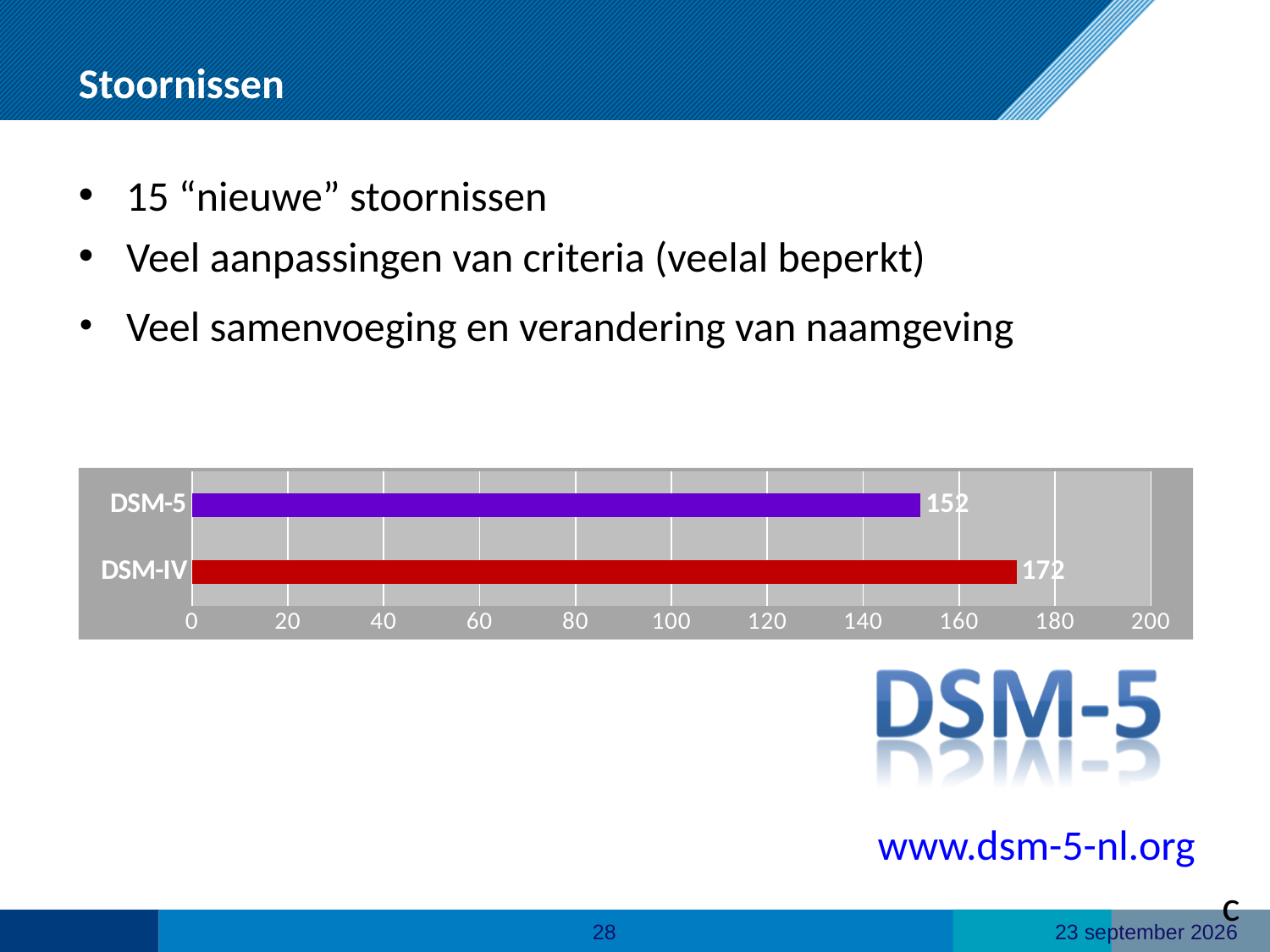
What kind of chart is shown on the slide? bar chart Is the value for DSM-5 greater or less than 140? greater What is the difference between the values for DSM-IV and DSM-5? 20 What is the value for DSM-IV? 172 Which is larger, the value for DSM-5 or the value for DSM-IV? DSM-IV Which category has the lowest value? DSM-5 What is the value for DSM-5? 152 What is the maximum value shown on the horizontal axis? 200 What colour is the bar for DSM-IV? red Is the value for DSM-IV greater or less than 180? less How many categories are shown in the chart? 2 Which category has the highest value? DSM-IV